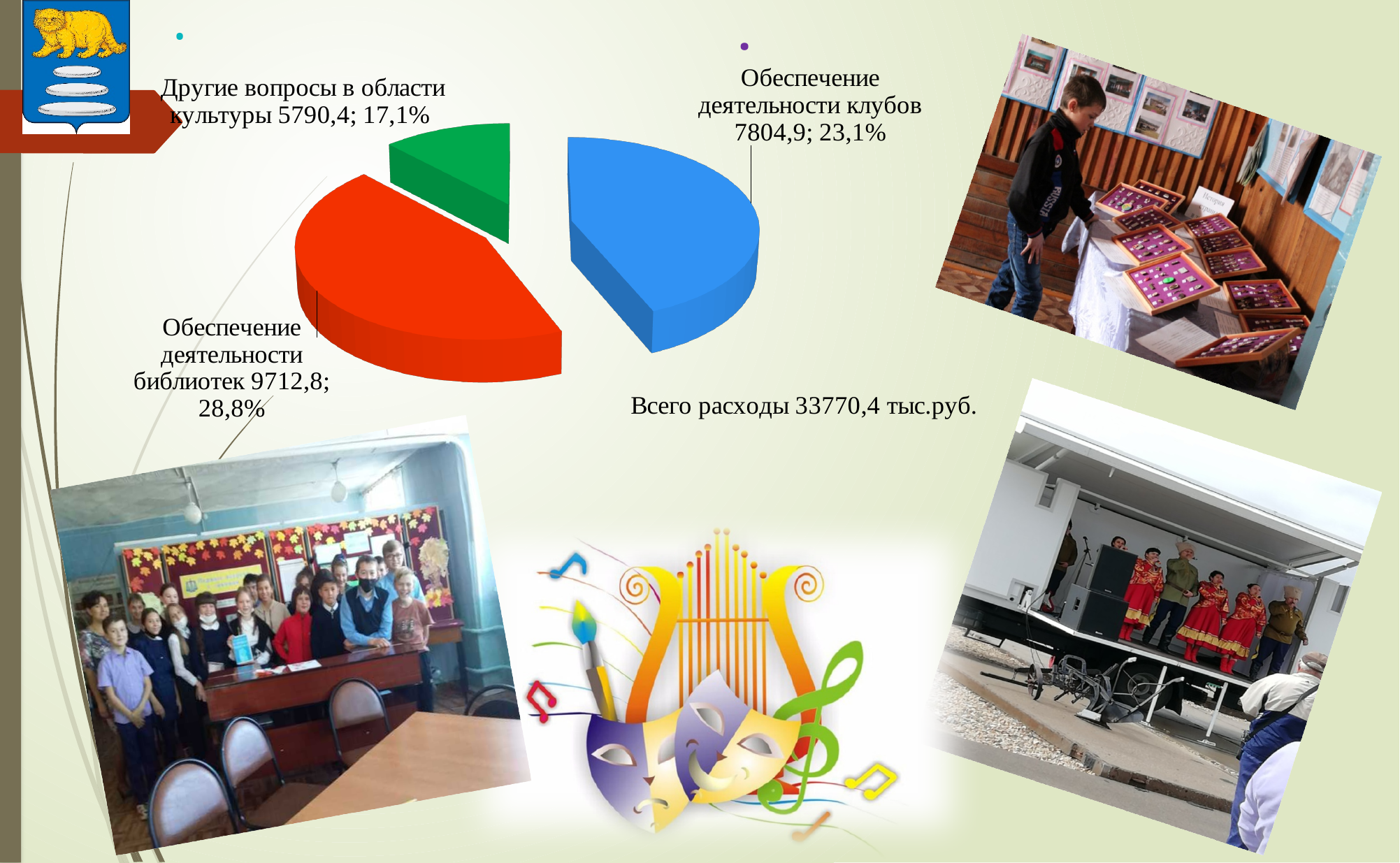
What is the value for "Обеспечение деятельности библиотек" in the pie chart? 9712,8 What share of the pie does "Обеспечение деятельности клубов" represent? 23,1% What is the value for "Другие вопросы в области культуры" in the pie chart? 5790,4 Which slice of the pie chart is the largest? Обеспечение деятельности библиотек What is the value for "Обеспечение деятельности клубов" in the pie chart? 7804,9 What is the difference between the values for "Обеспечение деятельности библиотек" and "Обеспечение деятельности клубов"? 1907,9 How many slices does the pie chart have? 3 Which is larger: the value for "Обеспечение деятельности клубов" or for "Другие вопросы в области культуры"? Обеспечение деятельности клубов What kind of chart is shown on the slide? Pie chart What share of the pie does "Обеспечение деятельности библиотек" represent? 28,8% Which slice of the pie chart is the smallest? Другие вопросы в области культуры What colour is the slice for "Обеспечение деятельности библиотек" in the pie chart? Red